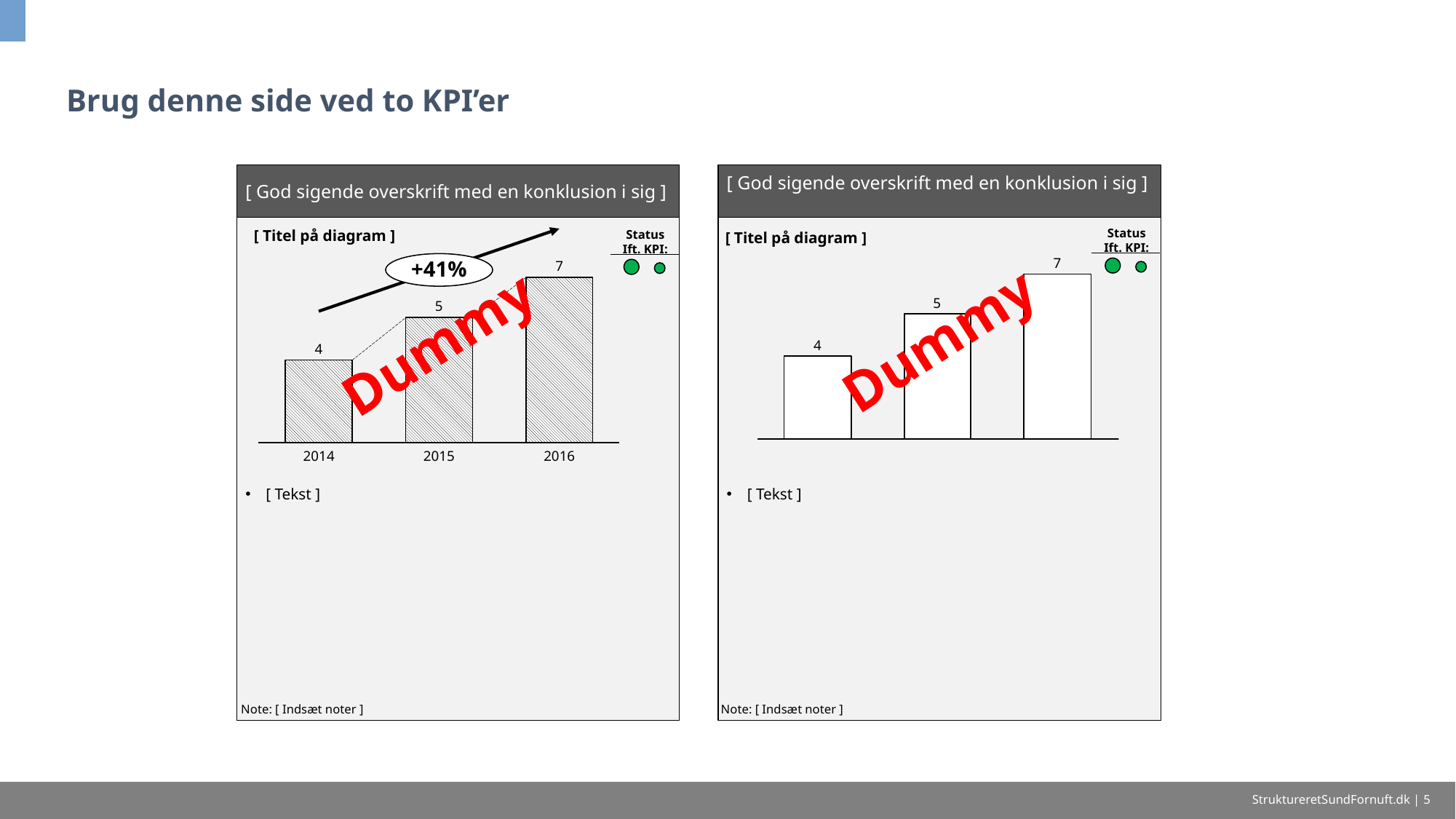
In the left chart, which year has the lowest value? 2014 In the left chart, what is the value for 2016? 7 In the left chart, what is the value for 2014? 4 What kind of chart is the left chart? Bar chart In the left chart, which year has the highest value? 2016 In the left chart, do the values rise or fall from 2014 to 2016? Rise How many bars are shown in the left chart? 3 What percentage change is shown in the oval annotation on the left chart? +41% How many bars are shown in the right chart? 3 In the left chart, which is larger, the value for 2015 or the value for 2014? 2015 In the right chart, what is the value of the tallest bar? 7 In the left chart, what is the difference between the values for 2016 and 2014? 3